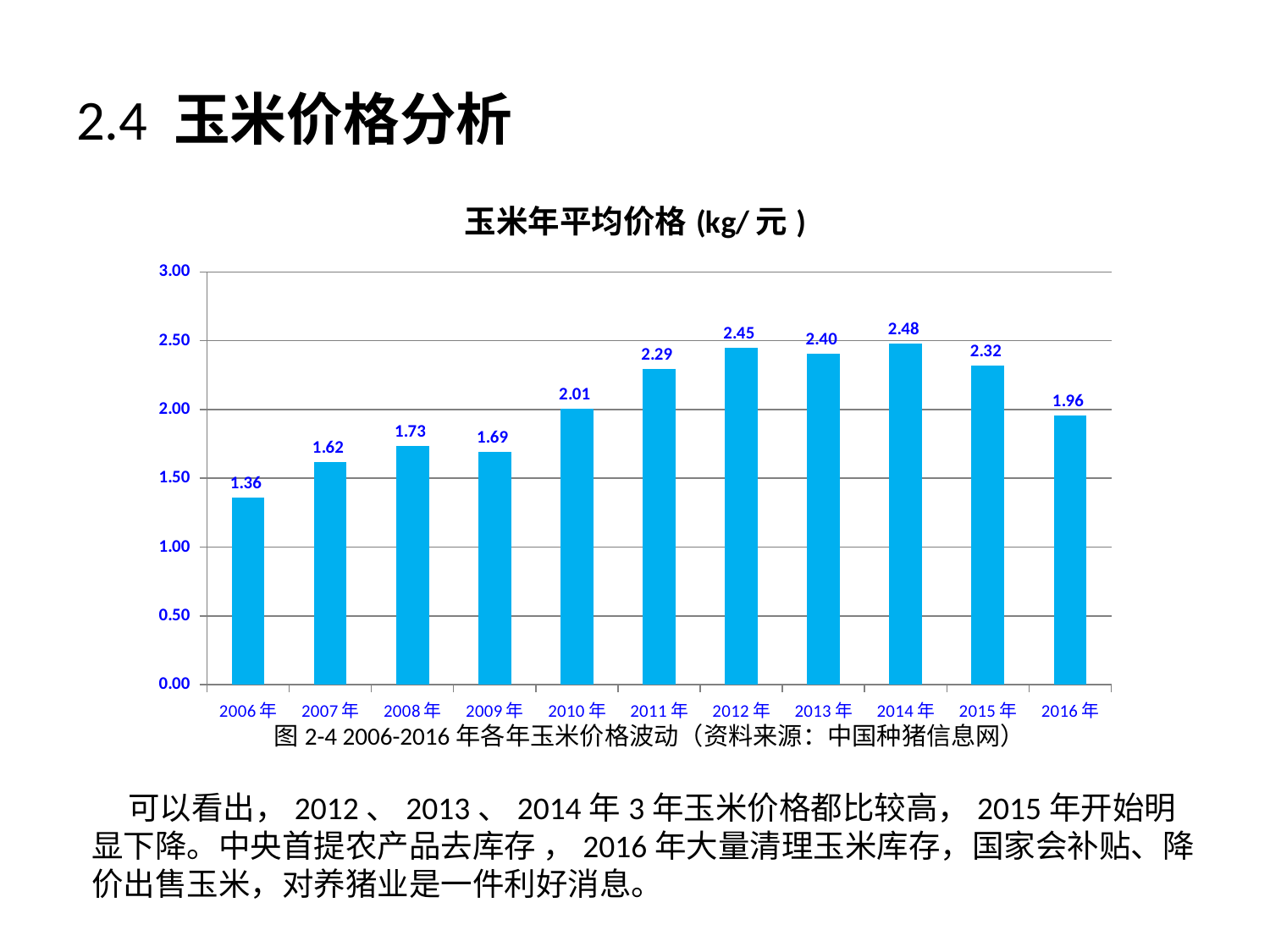
Is the value for 2011年 greater or less than 2.00? greater What is the title of the chart? 玉米年平均价格 (kg/ 元 ) What is the difference between the average corn price in 2014年 and 2016年? 0.52 Which year has the highest average corn price? 2014年 What is the average corn price for 2010年? 2.01 Which year has a higher average corn price, 2008年 or 2009年? 2008年 Which year has the lowest average corn price? 2006年 How many years are shown on the x axis of the chart? 11 What kind of chart is shown on the slide? bar chart Do the values rise or fall from 2014年 to 2016年? fall What is the average corn price for 2015年? 2.32 What is the average corn price for 2006年? 1.36